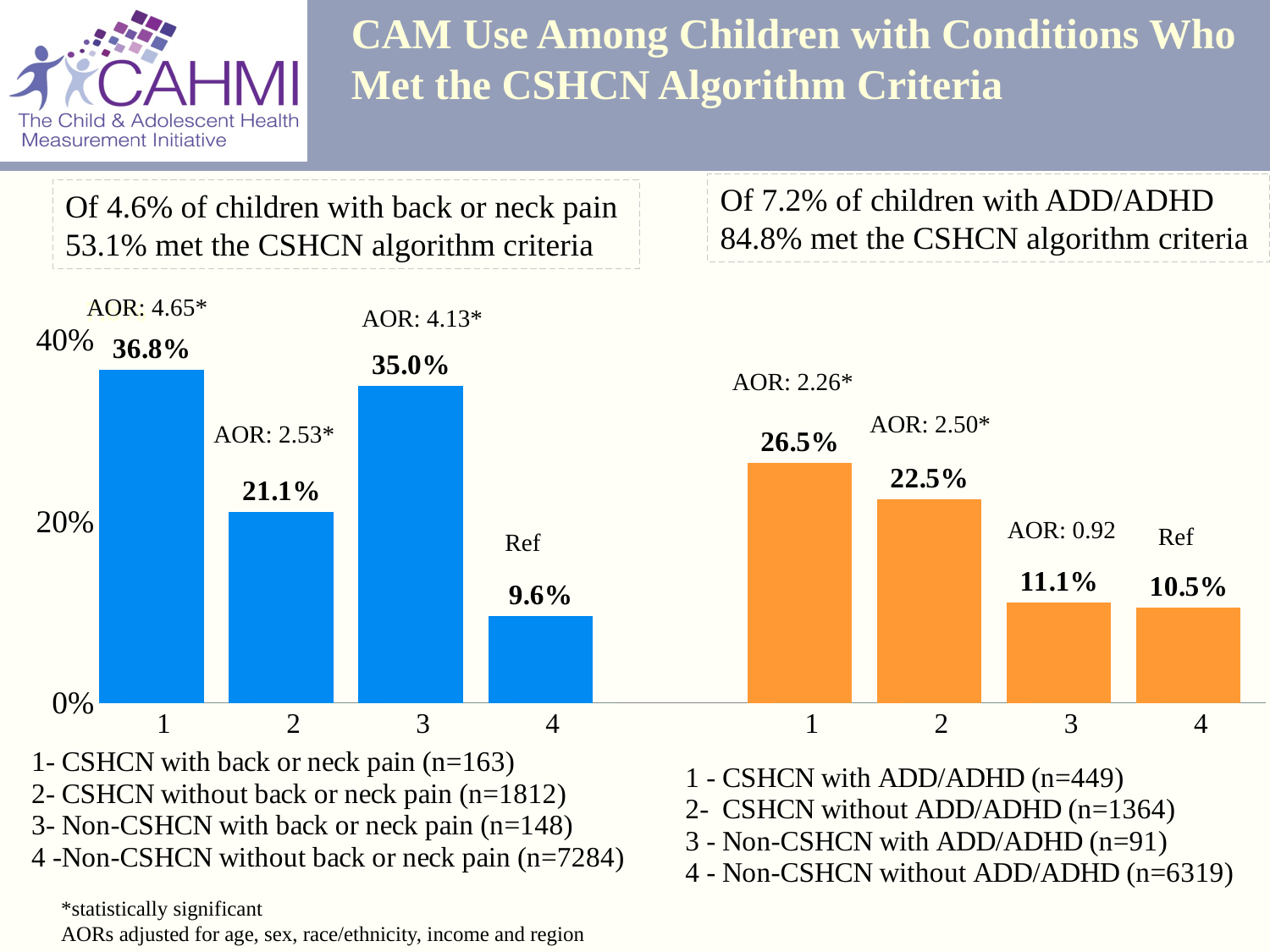
What colour are the bars in the left chart (back or neck pain)? blue In the right chart (ADD/ADHD), which category has the highest value? 1 In the right chart (ADD/ADHD), what is the difference between the values for category 3 and category 4? 0.6% In the right chart (ADD/ADHD), do the values rise or fall from category 1 to category 4? fall How many categories are shown in the left chart (back or neck pain)? 4 In the left chart (back or neck pain), what is the value for category 1? 36.8% In the right chart (ADD/ADHD), what is the value for category 2? 22.5% In the left chart (back or neck pain), which category has the lowest value? 4 What kind of chart is the right chart (ADD/ADHD)? bar chart In the left chart (back or neck pain), what is the difference between the values for category 1 and category 2? 15.7% In the left chart (back or neck pain), which is larger, the value for category 2 or category 3? 3 In the right chart (ADD/ADHD), is the value for category 1 greater or less than 20%? greater